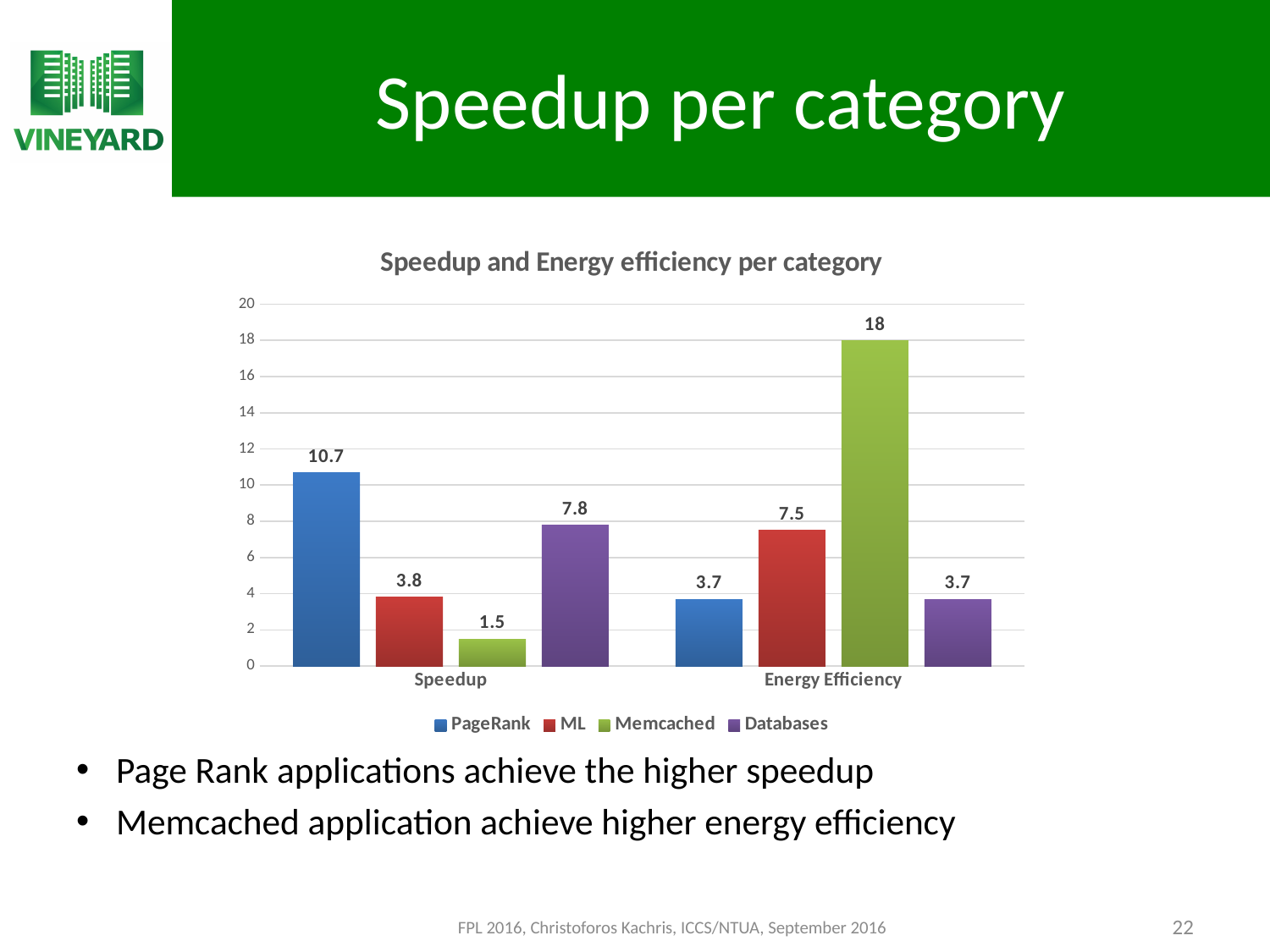
What is the Energy Efficiency value for ML? 7.5 Which is larger: the Speedup value for ML or the Speedup value for Databases? Databases Which series has the lowest Speedup value? Memcached What kind of chart is shown on the slide? Bar chart What is the Speedup value for Databases? 7.8 What is the Energy Efficiency value for Memcached? 18 What is the difference between the Memcached Energy Efficiency value and the Memcached Speedup value? 16.5 What is the Speedup value for PageRank? 10.7 Which series has the highest Energy Efficiency value? Memcached What is the title of the chart? Speedup and Energy efficiency per category How many series does the legend list? 4 Which series has the highest Speedup value? PageRank